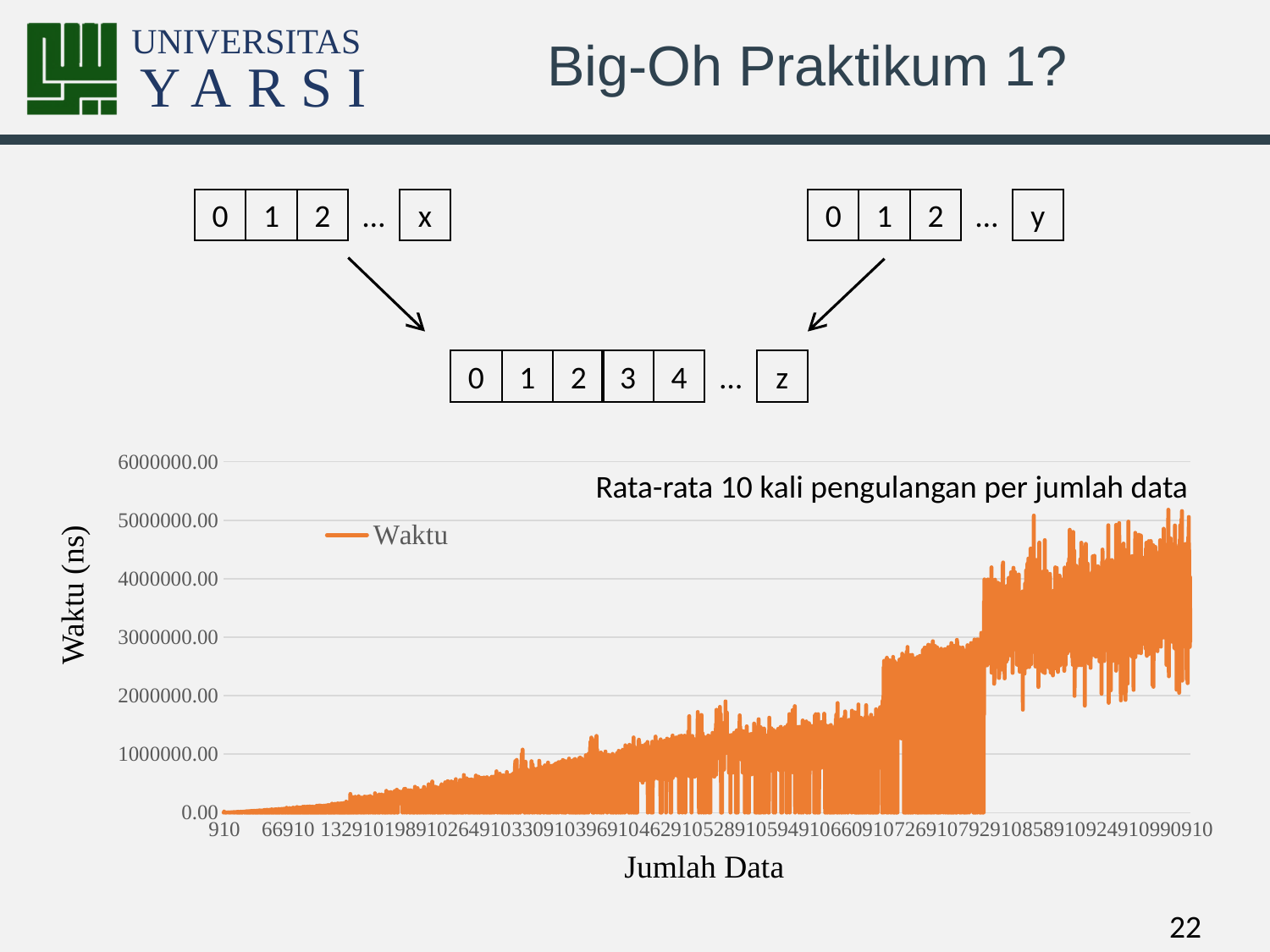
Is the Waktu value at Jumlah Data 66910 greater or less than 1000000.00? less What is the first Jumlah Data value shown on the x axis? 910 What is the name of the series shown in the chart legend? Waktu Overall, do the Waktu values rise or fall as Jumlah Data increases along the x axis? rise Is the Waktu value at Jumlah Data 990910 greater or less than 1000000.00? greater How many series does the chart legend list? 1 What is the highest value shown on the chart's y axis? 6000000.00 What kind of chart is shown on the slide? line chart Is the Waktu value at Jumlah Data 330910 greater or less than 2000000.00? less Which has the larger Waktu value: Jumlah Data 66910 or Jumlah Data 990910? 990910 What is the title of the chart's x axis? Jumlah Data